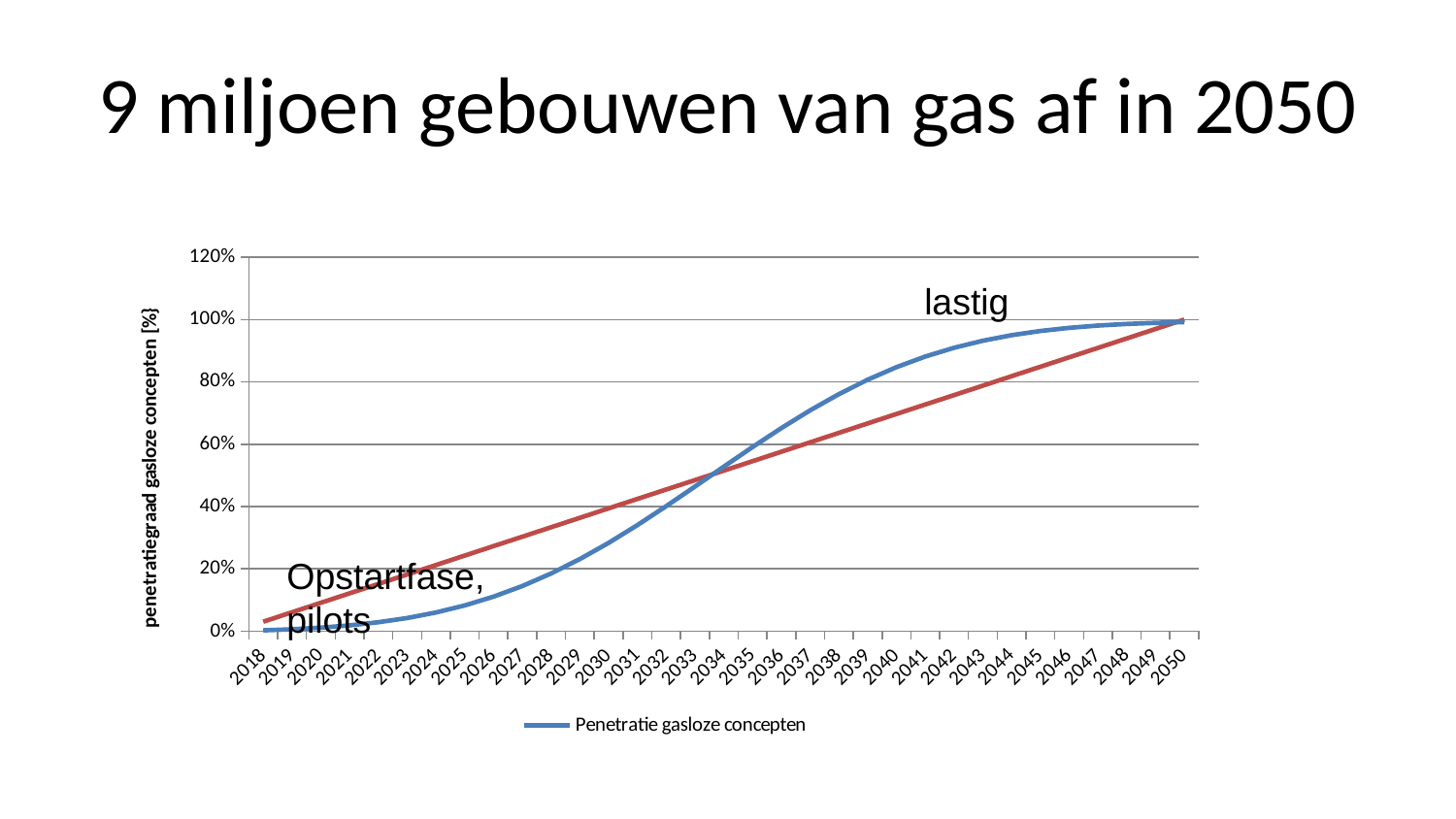
In 2040, which line is higher: the red straight line or the blue 'Penetratie gasloze concepten' curve? the blue curve How many years are shown along the x axis of the chart? 33 Does the blue 'Penetratie gasloze concepten' curve rise or fall from 2018 to 2050? rise Is the value of the blue 'Penetratie gasloze concepten' curve in 2025 greater or less than 20%? less Is the value of the blue 'Penetratie gasloze concepten' curve in 2041 greater or less than 80%? greater What kind of chart is shown on the slide? line chart What is the label on the y axis of the chart? penetratiegraad gasloze concepten [%] In 2030, which line is higher: the red straight line or the blue 'Penetratie gasloze concepten' curve? the red straight line Is the value of the blue 'Penetratie gasloze concepten' curve in 2030 greater or less than 40%? less How many series does the chart legend list? 1 What is the highest tick value shown on the y axis of the chart? 120%